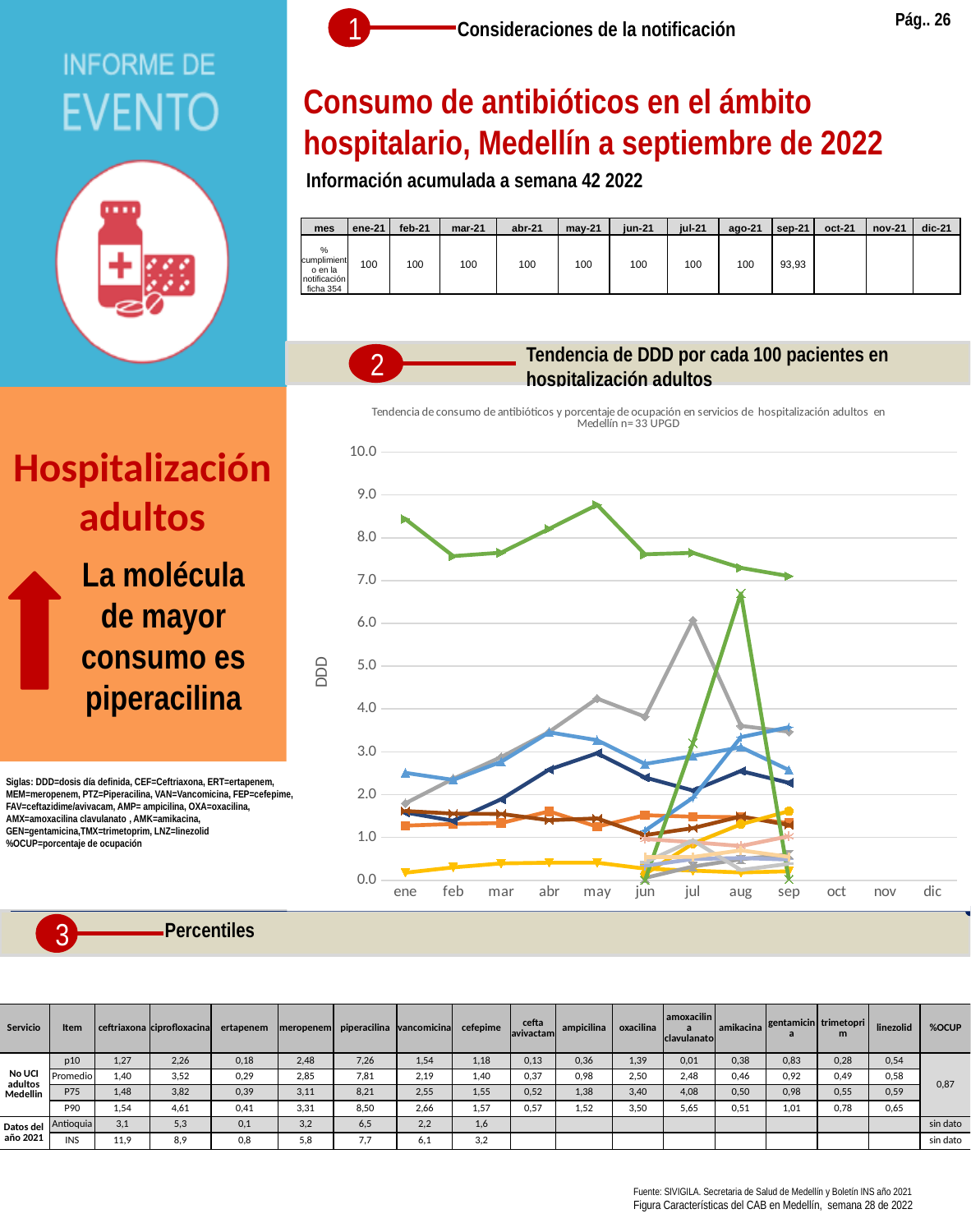
Does the topmost line rise or fall from may to sep? fall Is the peak of the line that spikes sharply in aug greater or less than 6.0? greater What is the highest value shown on the y axis of the line chart? 10.0 Is the value of the topmost line in may greater or less than 8.0? greater In which month does the topmost line of the chart reach its highest value? may Through which month does the line chart have plotted data? sep How many month labels are shown on the x axis of the line chart? 12 How many UPGD does the chart title say are included (n=)? 33 Is the value of the topmost line in ene greater or less than 8.0? greater What kind of chart is shown under 'Tendencia de DDD por cada 100 pacientes en hospitalización adultos'? line chart What is the title of the y axis of the line chart? DDD